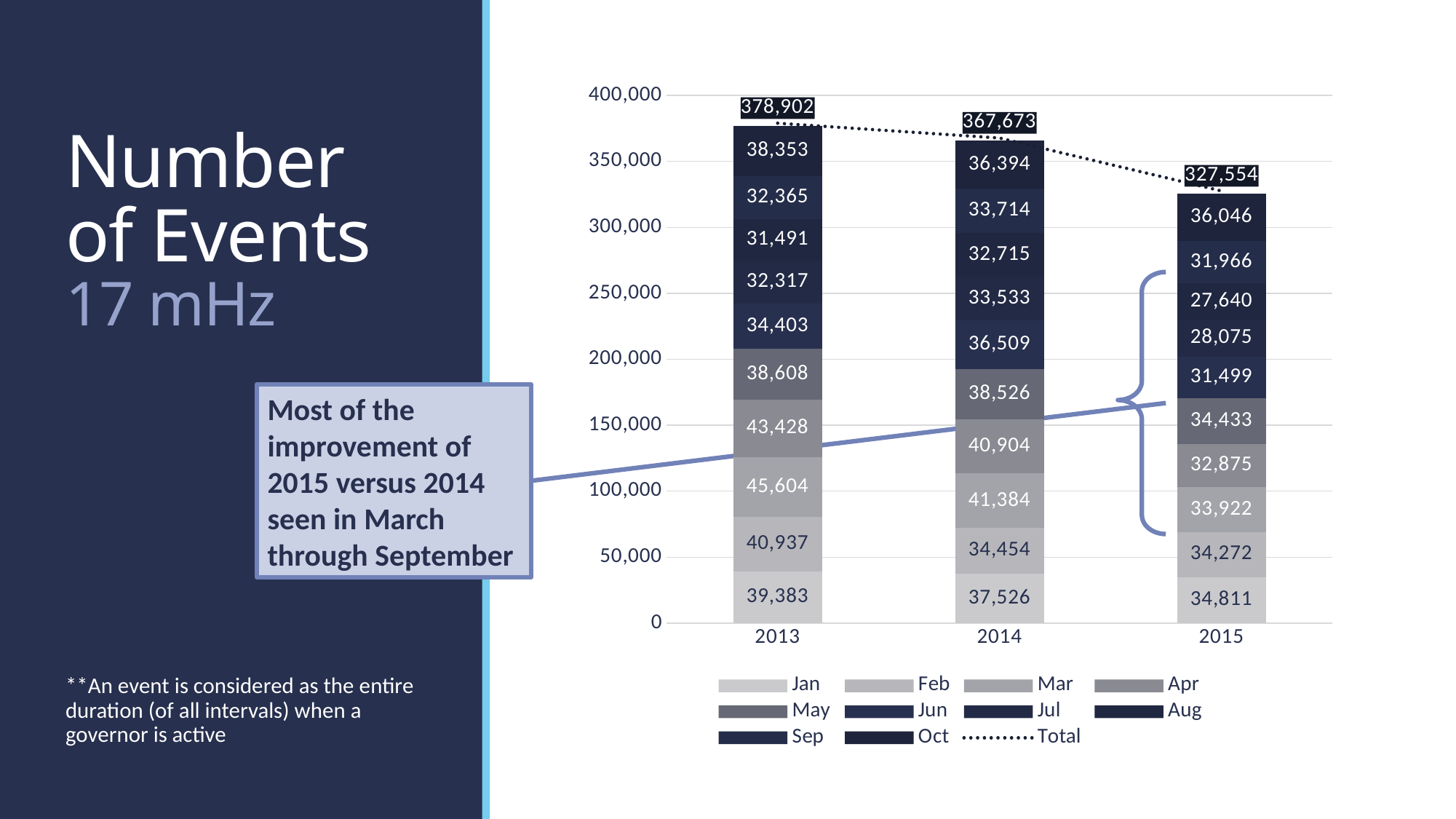
What is the difference between the 2014 total and the 2015 total? 40,119 Which year has the highest total number of events? 2013 Do the yearly totals rise or fall from 2013 to 2015? fall How many years (bars) are shown on the x axis? 3 How many series does the legend list? 11 What is the total number of events shown for 2013? 378,902 What is the value of the bottom (Jan) segment of the 2014 bar? 37,526 What is the difference between the 2013 total and the 2014 total? 11,229 What is the value of the top (Oct) segment of the 2015 bar? 36,046 What is the total number of events shown for 2015? 327,554 Is the total for 2015 greater or less than 350,000? less Which year has the lowest total number of events? 2015